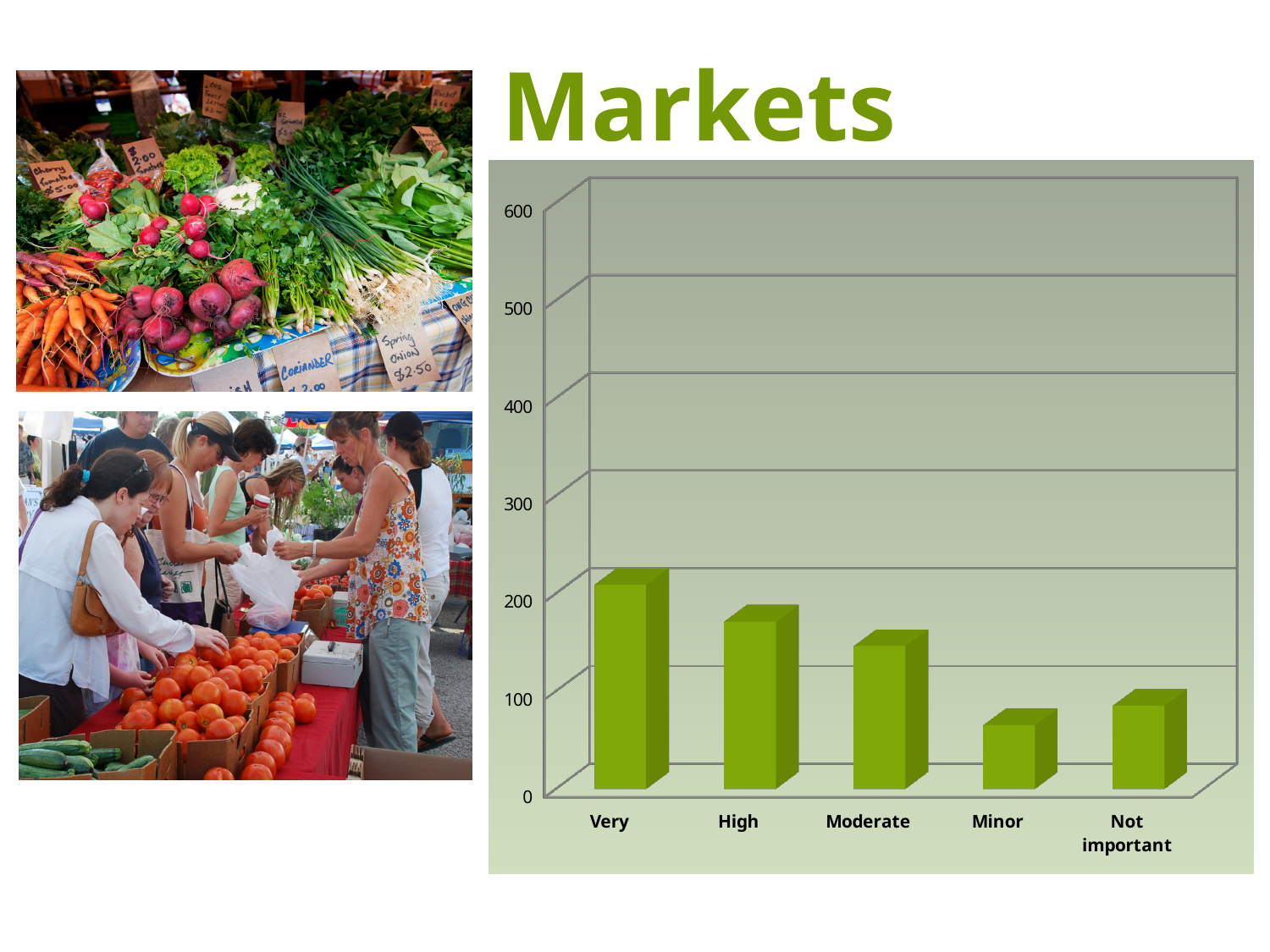
Do the bar values rise or fall going from Very to Minor along the x axis? fall Is the value for Moderate greater or less than 100? greater Which category has the highest bar in the chart? Very What is the title of the slide containing the chart? Markets Is the value for Very greater or less than 100? greater Which is larger, the value for Very or the value for High? Very How many categories are shown on the x axis of the chart? 5 Is the value for Minor greater or less than 100? less Which category has the lowest bar in the chart? Minor Which is larger, the value for Minor or the value for Not important? Not important What kind of chart is shown on the slide? bar chart